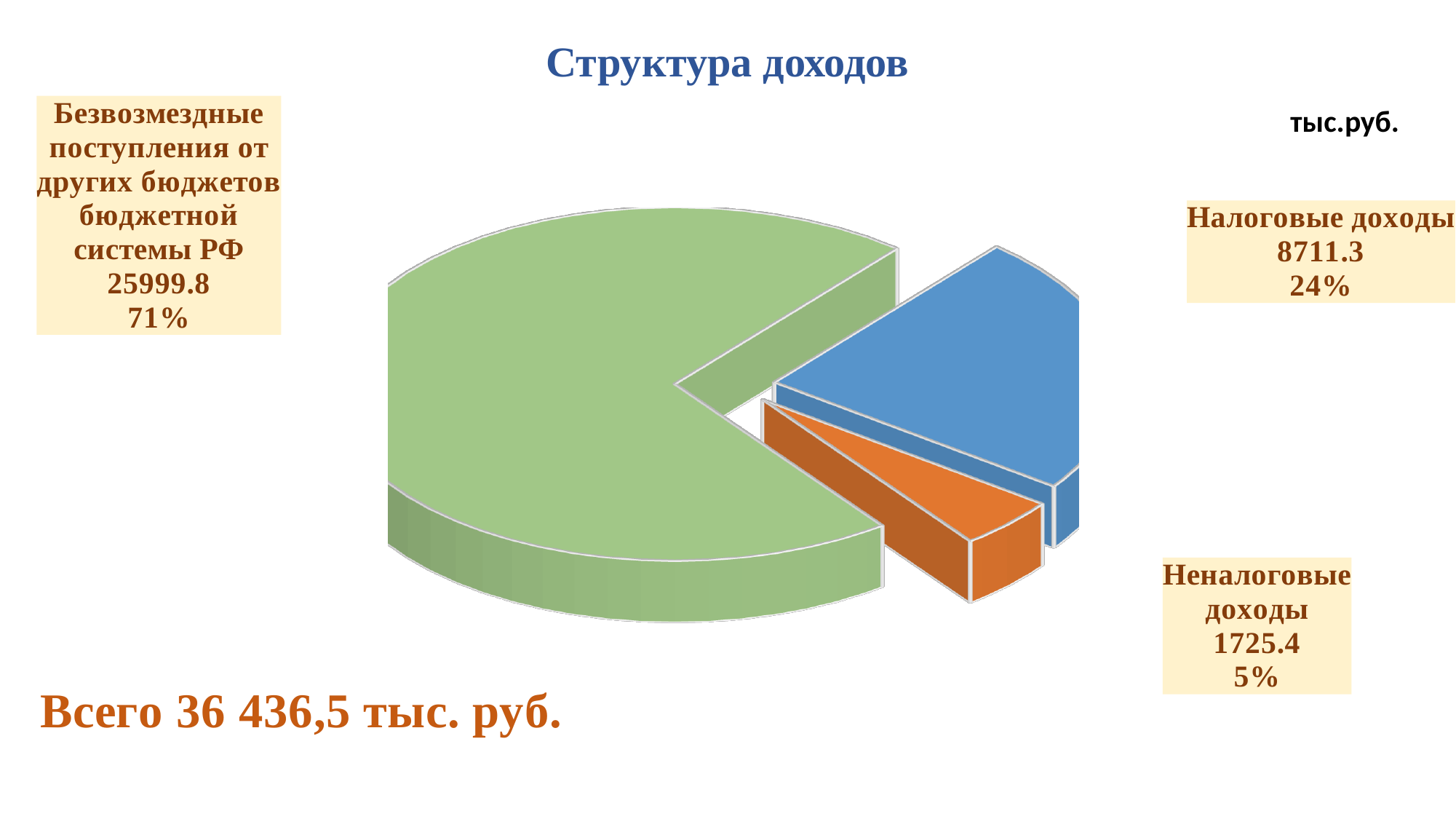
What is the value for Безвозмездные поступления от других бюджетов бюджетной системы РФ? 25999.8 What share of the pie does Налоговые доходы represent? 24% What is the value for Неналоговые доходы? 1725.4 What share of the pie does Безвозмездные поступления от других бюджетов бюджетной системы РФ represent? 71% What type of chart is shown on the slide? Pie chart What is the difference between the values for Налоговые доходы and Неналоговые доходы? 6985.9 Which category has the largest slice? Безвозмездные поступления от других бюджетов бюджетной системы РФ Which category has the smallest slice? Неналоговые доходы What is the value for Налоговые доходы? 8711.3 Which is larger, Налоговые доходы or Неналоговые доходы? Налоговые доходы How many slices does the pie chart have? 3 What is the title of the chart? Структура доходов